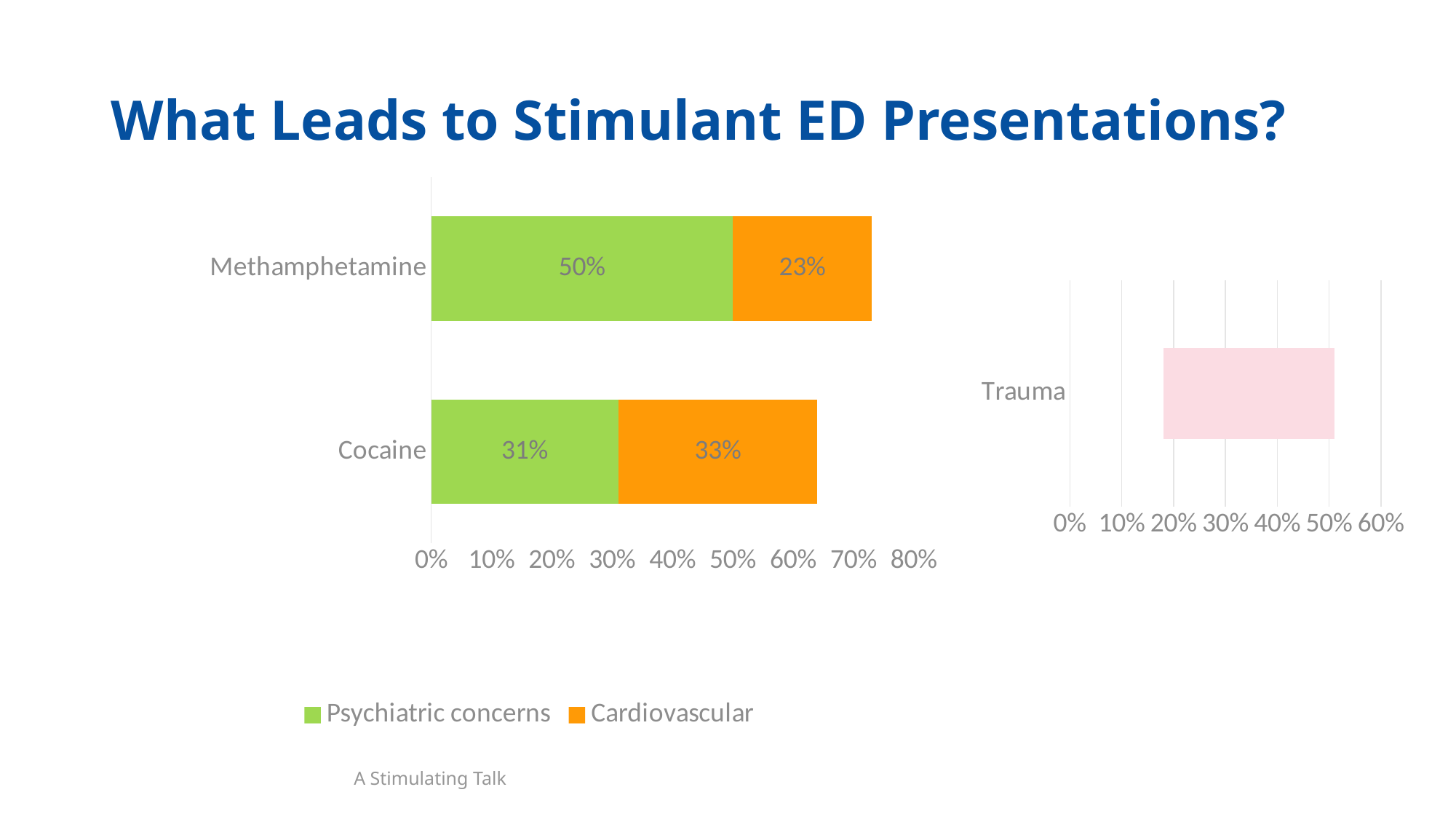
How many series does the legend of the left chart list? 2 In the left chart, what is the Cardiovascular value for Cocaine? 33% In the left chart, which is larger for Cocaine: Psychiatric concerns or Cardiovascular? Cardiovascular In the left chart, what is the Psychiatric concerns value for Cocaine? 31% In the left chart, what is the difference between the Psychiatric concerns values for Methamphetamine and Cocaine? 19% In the left chart, what is the total of the stacked bar for Cocaine? 64% In the right chart, does the Trauma bar extend to a value greater or less than 40%? greater What kind of chart is the left chart? Stacked bar chart In the left chart, what is the Psychiatric concerns value for Methamphetamine? 50% In the left chart, what is the Cardiovascular value for Methamphetamine? 23% In the left chart, what is the total of the stacked bar for Methamphetamine? 73% In the left chart, which category has the higher Cardiovascular value? Cocaine